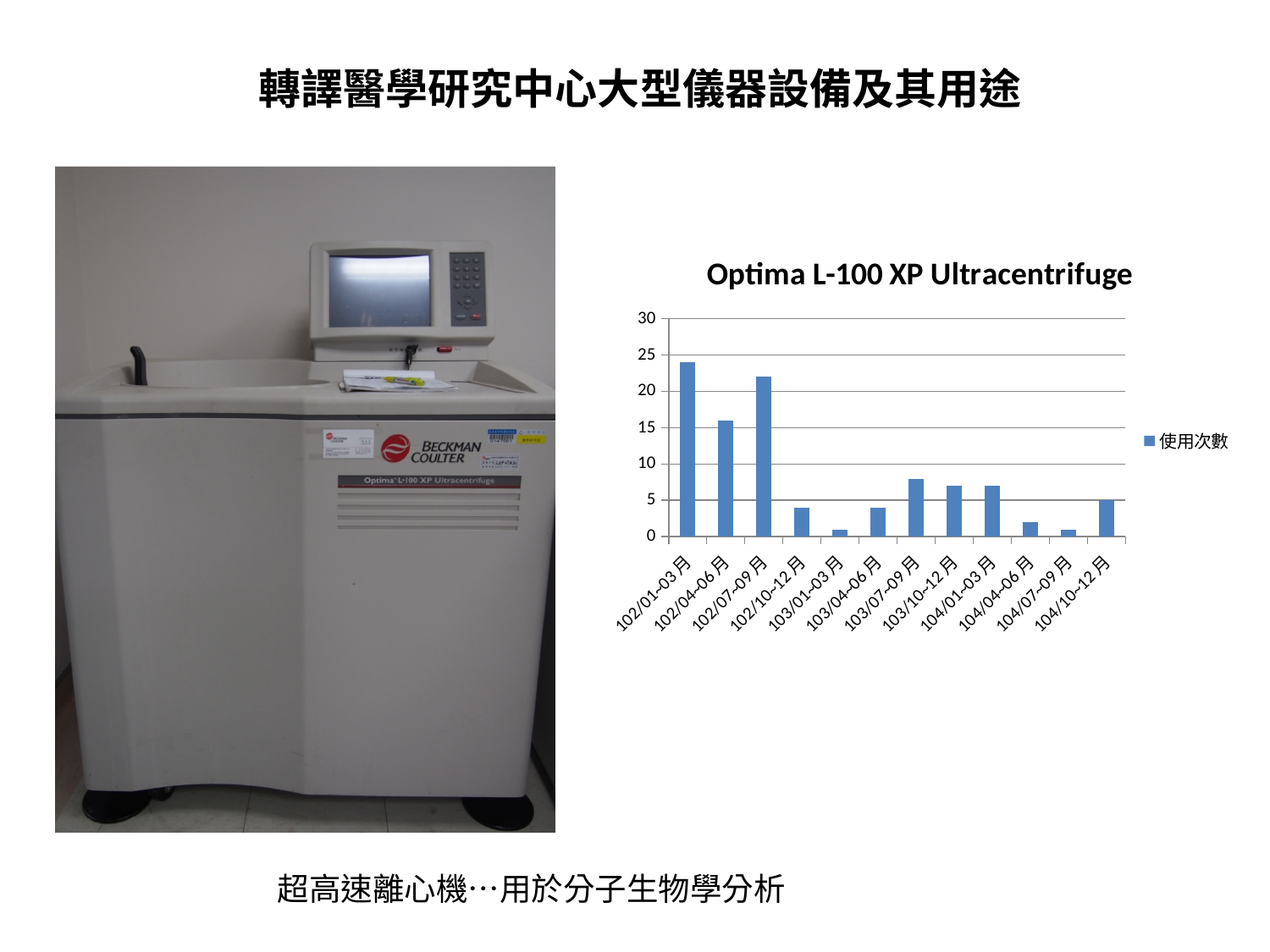
How many series does the legend list? 1 Is the value for 102/01~03月 greater or less than 20? greater Which is larger, the value for 102/07~09月 or the value for 102/04~06月? 102/07~09月 Is the value for 103/07~09月 greater or less than 10? less Is the value for 102/10~12月 greater or less than 5? less What is the title of the chart? Optima L-100 XP Ultracentrifuge Which is larger, the value for 104/10~12月 or the value for 104/04~06月? 104/10~12月 Which period has the highest value? 102/01~03月 What is the name of the series shown in the legend? 使用次數 What kind of chart is shown on the slide? bar chart How many categories (time periods) are shown on the x axis? 12